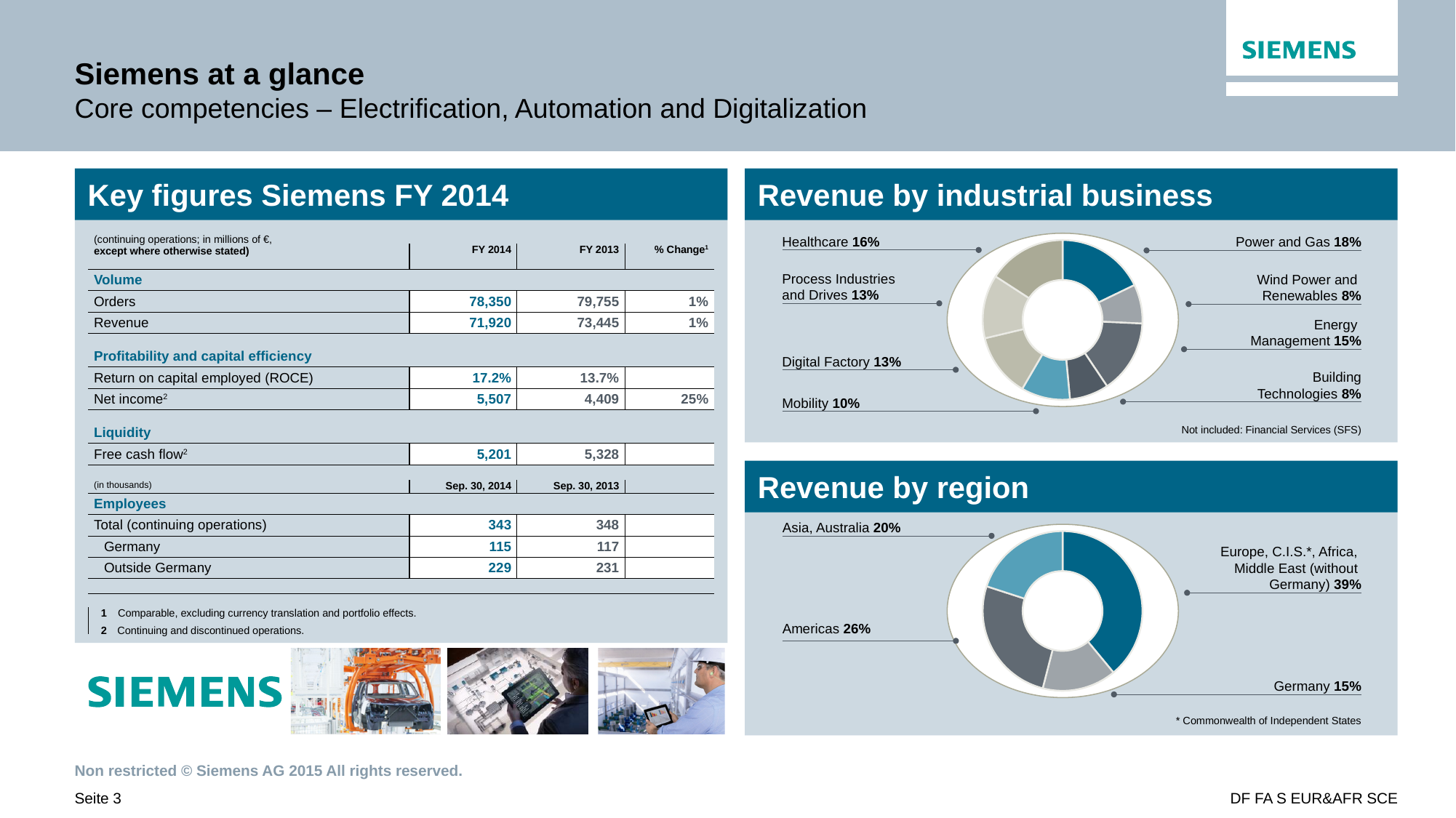
What kind of chart is 'Revenue by region'? Donut (pie) chart In the 'Revenue by industrial business' chart, what share does Power and Gas have? 18% In the 'Revenue by industrial business' chart, what share does Healthcare have? 16% In the 'Revenue by industrial business' chart, how many business segments are shown? 8 In the 'Revenue by region' chart, what is the difference between the Europe, C.I.S., Africa, Middle East (without Germany) share and the Asia, Australia share? 19% According to the note under the 'Revenue by industrial business' chart, which business is not included? Financial Services (SFS) In the 'Revenue by industrial business' chart, which is larger, Healthcare or Digital Factory? Healthcare In the 'Revenue by region' chart, how many regions are shown? 4 In the 'Revenue by industrial business' chart, what is the difference between the Energy Management share and the Mobility share? 5% In the 'Revenue by region' chart, what share does the Americas have? 26% In the 'Revenue by region' chart, which region has the smallest share? Germany In the 'Revenue by industrial business' chart, which business has the largest share? Power and Gas